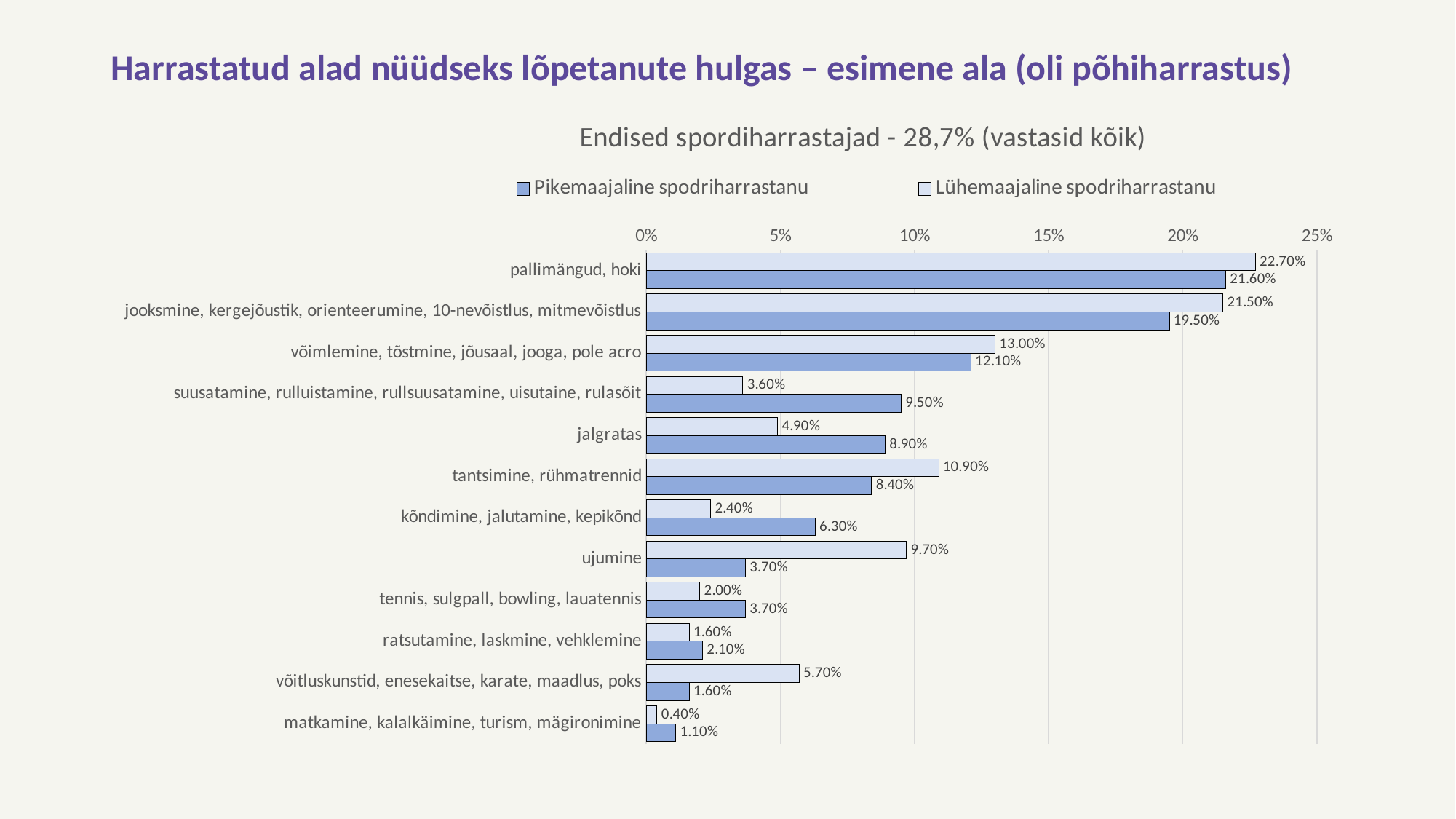
What kind of chart is shown on the slide? bar chart For "tantsimine, rühmatrennid", which series has the larger value: "Pikemaajaline spodriharrastanu" or "Lühemaajaline spodriharrastanu"? Lühemaajaline spodriharrastanu Which category has the lowest value for "Pikemaajaline spodriharrastanu"? matkamine, kalalkäimine, turism, mägironimine What is the value for "Lühemaajaline spodriharrastanu" in the category "ujumine"? 9.70% Which category has the highest value for "Lühemaajaline spodriharrastanu"? pallimängud, hoki What is the difference between the "Lühemaajaline spodriharrastanu" and "Pikemaajaline spodriharrastanu" values for "suusatamine, rulluistamine, rullsuusatamine, uisutaine, rulasõit"? 5.90% What is the value for "Pikemaajaline spodriharrastanu" in the category "pallimängud, hoki"? 21.60% How many series does the legend list? 2 What is the value for "Pikemaajaline spodriharrastanu" in the category "jalgratas"? 8.90% What is the title of the chart? Endised spordiharrastajad - 28,7% (vastasid kõik) How many categories are shown on the chart? 12 Is the "Pikemaajaline spodriharrastanu" value for "jooksmine, kergejõustik, orienteerumine, 10-nevõistlus, mitmevõistlus" greater or less than 15%? greater